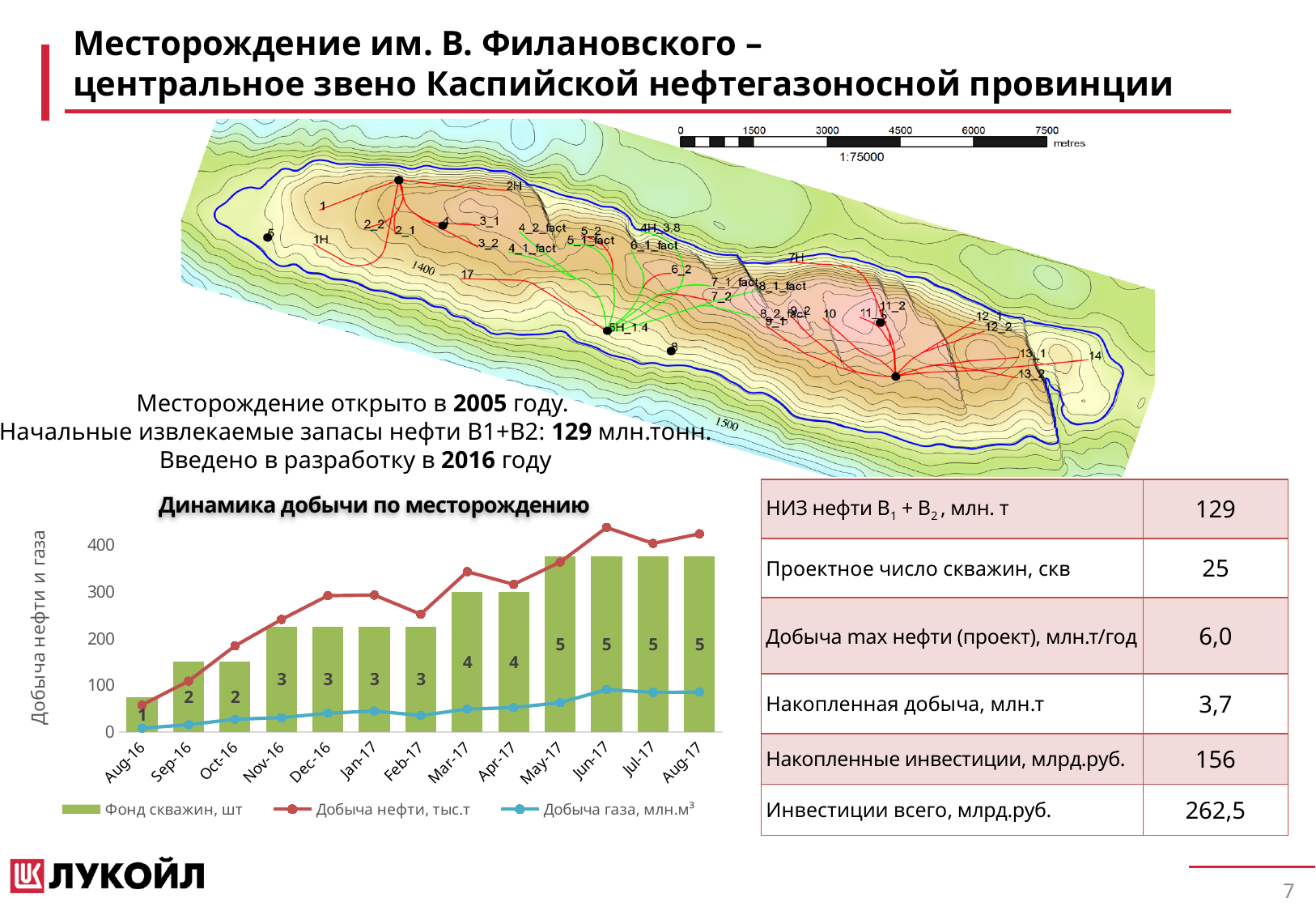
What is the title of the chart on the slide? Динамика добычи по месторождению What is the value of Фонд скважин, шт for Nov-16? 3 Is the value of Добыча нефти, тыс.т for Jun-17 greater or less than 400? greater What is the difference in Фонд скважин, шт between Aug-17 and Aug-16? 4 Which month has a larger Фонд скважин, шт: Feb-17 or Mar-17? Mar-17 Is the value of Добыча газа, млн.м³ for Aug-17 greater or less than 100? less How many months are shown on the x axis of the chart? 13 What kind of chart is 'Динамика добычи по месторождению'? Combined bar and line chart How many series does the chart legend list? 3 Does the Добыча нефти, тыс.т line generally rise or fall from Aug-16 to Aug-17? Rise What is the value of Фонд скважин, шт for Aug-17? 5 Which month has the lowest value of Фонд скважин, шт? Aug-16